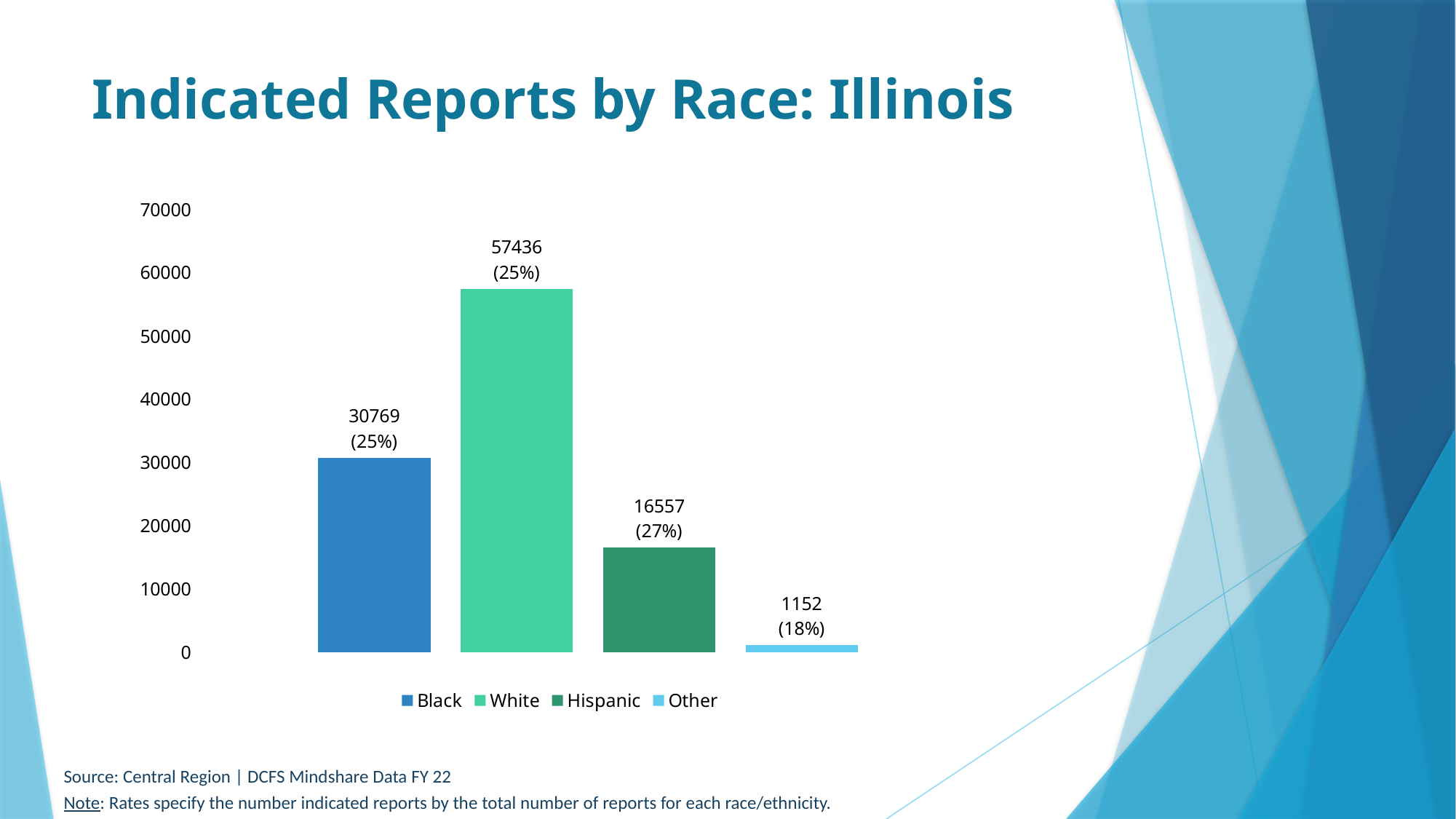
What kind of chart is shown on the slide? Bar chart What is the title of the slide? Indicated Reports by Race: Illinois Which race has the lowest number of indicated reports? Other What is the number of indicated reports for Black? 30769 What rate (percentage) is shown for Hispanic? 27% Which has more indicated reports, Black or Hispanic? Black How many categories are shown in the legend? 4 Which race has the highest number of indicated reports? White What is the number of indicated reports for White? 57436 What is the number of indicated reports for Other? 1152 What is the difference between the number of indicated reports for White and Black? 26667 What is the number of indicated reports for Hispanic? 16557